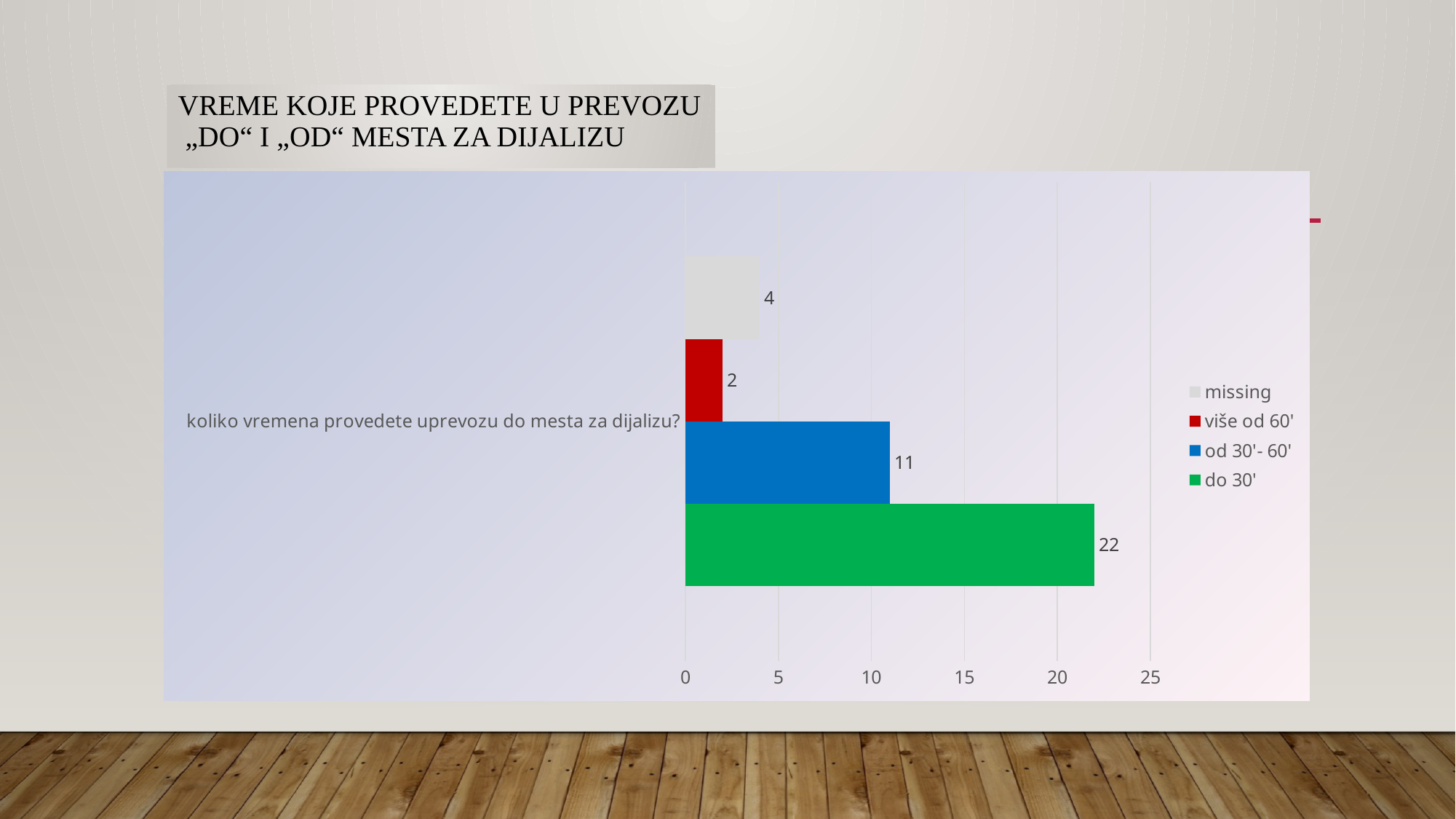
Which is larger, the value for 'missing' or the value for 'više od 60''? missing Which series has the highest value? do 30' What is the value for the 'od 30'- 60'' series? 11 What is the value for the 'missing' series? 4 Is the value for 'do 30'' greater or less than 20? greater What is the difference between the values for 'do 30'' and 'od 30'- 60''? 11 What is the value for the 'više od 60'' series? 2 What is the value for the 'do 30'' series? 22 How many series does the legend list? 4 What colour is the bar for the 'od 30'- 60'' series? blue What kind of chart is shown on the slide? bar chart Which series has the lowest value? više od 60'